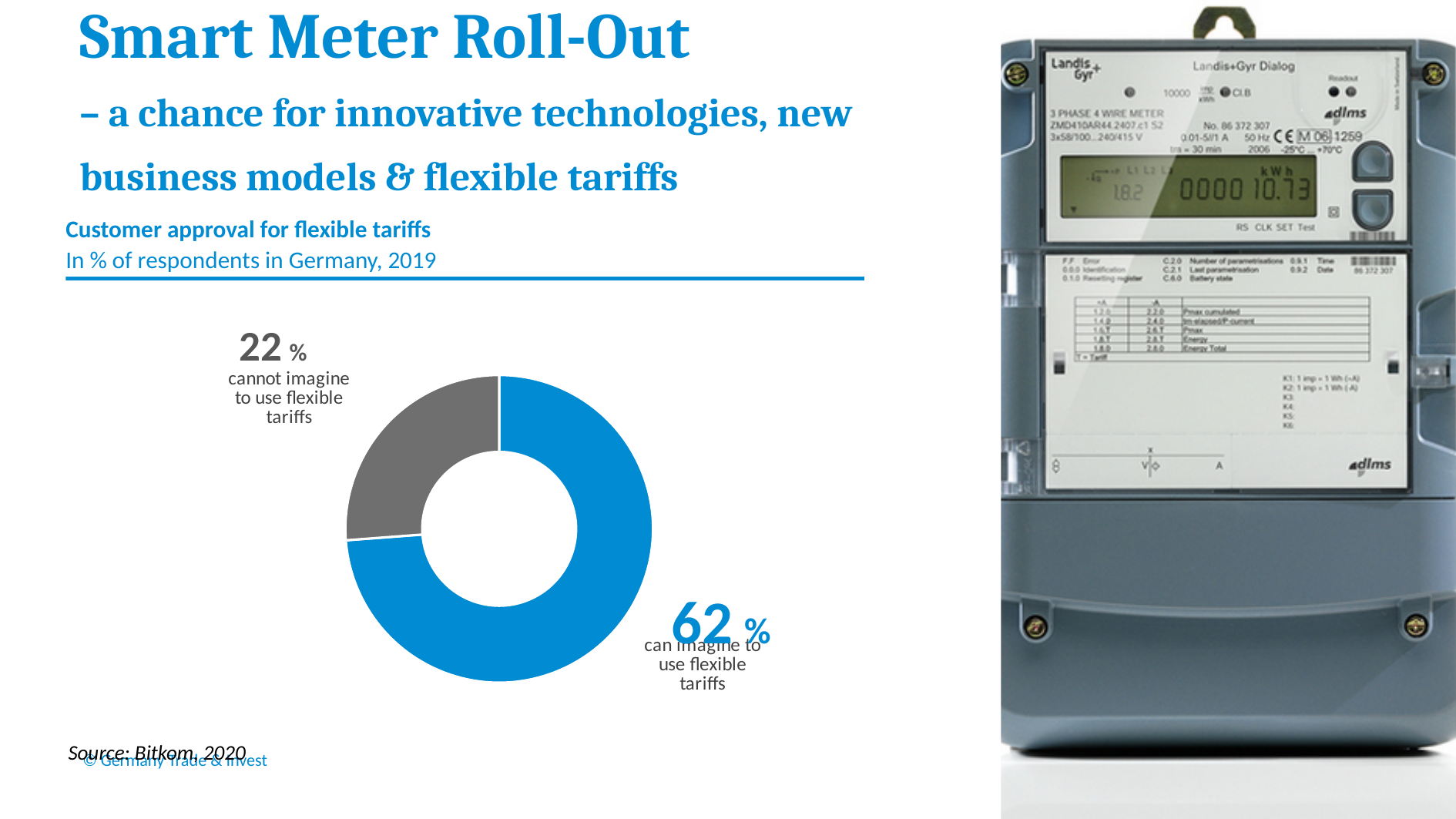
What is the source of the chart data? Bitkom, 2020 Is the share for 'cannot imagine to use flexible tariffs' larger or smaller than the share for 'can imagine to use flexible tariffs'? smaller Which year and country does the chart's data refer to? Germany, 2019 How many labelled slices does the chart have? 2 Which response has the larger share: 'can imagine to use flexible tariffs' or 'cannot imagine to use flexible tariffs'? can imagine to use flexible tariffs Which colour represents respondents who can imagine to use flexible tariffs? Blue What percentage of respondents cannot imagine to use flexible tariffs? 22 % What kind of chart is shown on the slide? Pie chart (donut) What percentage of respondents can imagine to use flexible tariffs? 62 % Which response has the smaller share in the chart? cannot imagine to use flexible tariffs What is the title of the chart? Customer approval for flexible tariffs By how many percentage points does 'can imagine to use flexible tariffs' exceed 'cannot imagine to use flexible tariffs'? 40 percentage points